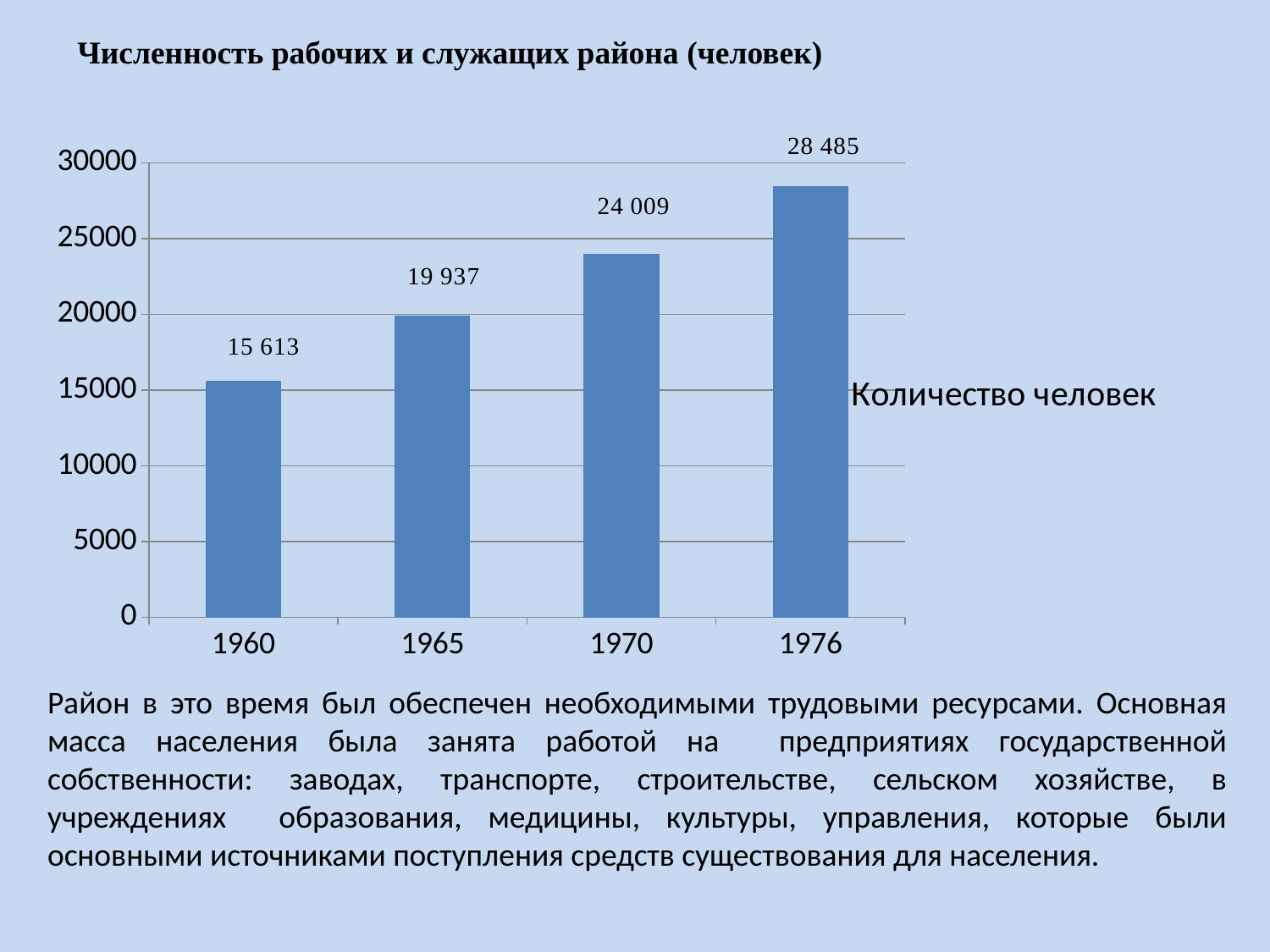
What is the difference between the values for 1970 and 1965? 4 072 Which year has the highest value? 1976 Which year has the lowest value? 1960 What is the value for 1970? 24 009 Do the values rise or fall from 1960 to 1976? Rise How many years are shown on the x axis? 4 What is the value for 1976? 28 485 What is the difference between the values for 1976 and 1960? 12 872 What is the value for 1965? 19 937 What is the value for 1960? 15 613 What kind of chart is shown on the slide? Bar chart Which is larger, the value for 1965 or the value for 1970? 1970